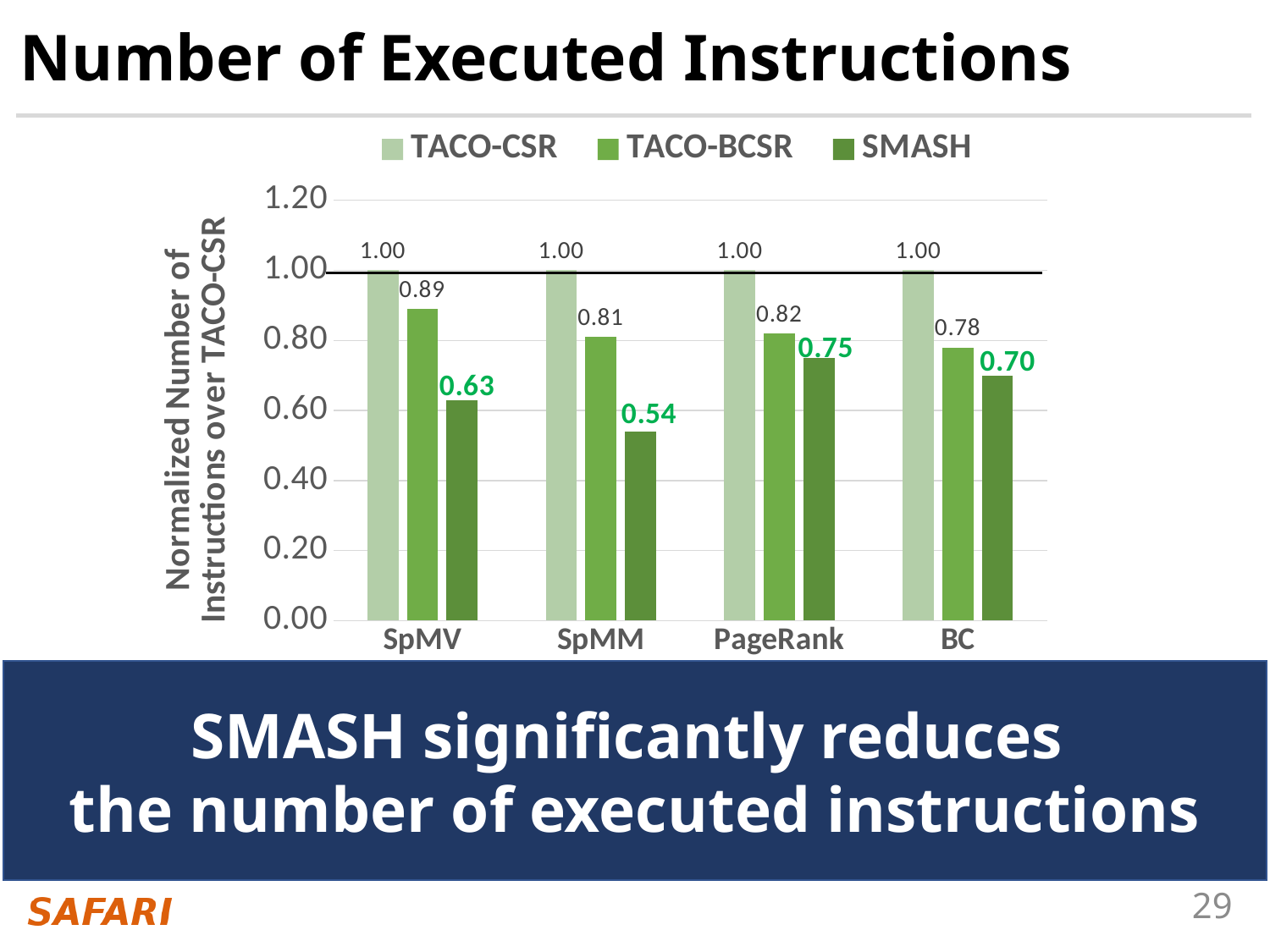
How many series does the legend list? 3 Which category has the highest TACO-BCSR value? SpMV Is the SMASH value for SpMM greater or less than 0.60? less Which is larger, the SMASH value for PageRank or the SMASH value for BC? PageRank What is the TACO-BCSR value for PageRank? 0.82 How many categories are shown on the x axis? 4 What is the label of the y axis? Normalized Number of Instructions over TACO-CSR What is the SMASH value for BC? 0.70 What is the SMASH value for SpMM? 0.54 What kind of chart is shown on the slide? bar chart What is the difference between the TACO-BCSR and SMASH values for SpMV? 0.26 Which category has the lowest SMASH value? SpMM